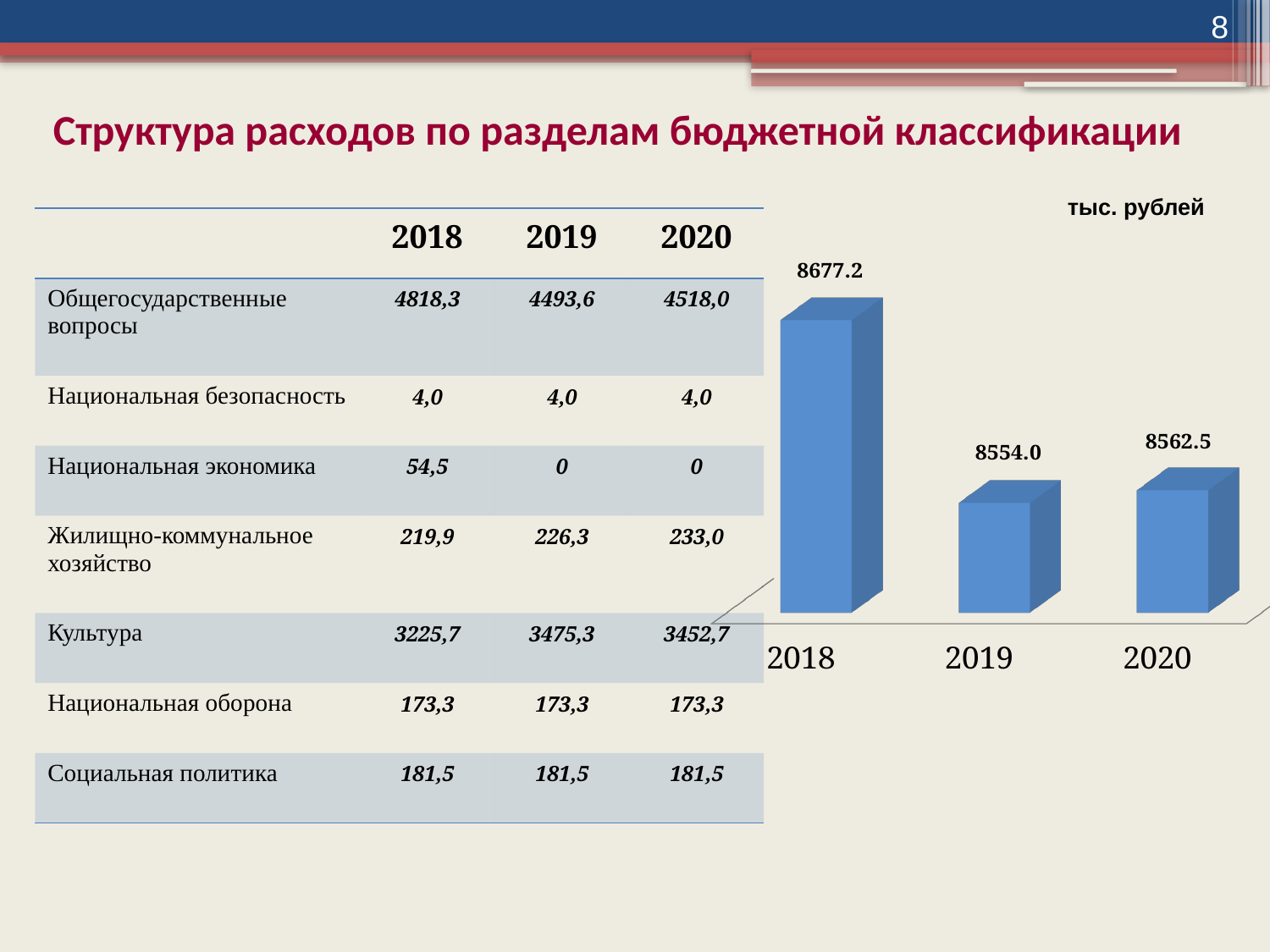
What is the value shown for 2019 on the bar chart? 8554.0 On the bar chart, which is larger: the value for 2018 or the value for 2020? 2018 On the bar chart, what is the difference between the values for 2018 and 2020? 114.7 What kind of chart is shown on the right of the slide? bar chart What is the value shown for 2018 on the bar chart? 8677.2 Which year has the lowest value on the bar chart? 2019 How many bars are shown on the bar chart? 3 What is the value shown for 2020 on the bar chart? 8562.5 On the bar chart, what is the difference between the values for 2018 and 2019? 123.2 What unit label is shown above the bar chart? тыс. рублей On the bar chart, what is the difference between the values for 2020 and 2019? 8.5 Which year has the highest value on the bar chart? 2018